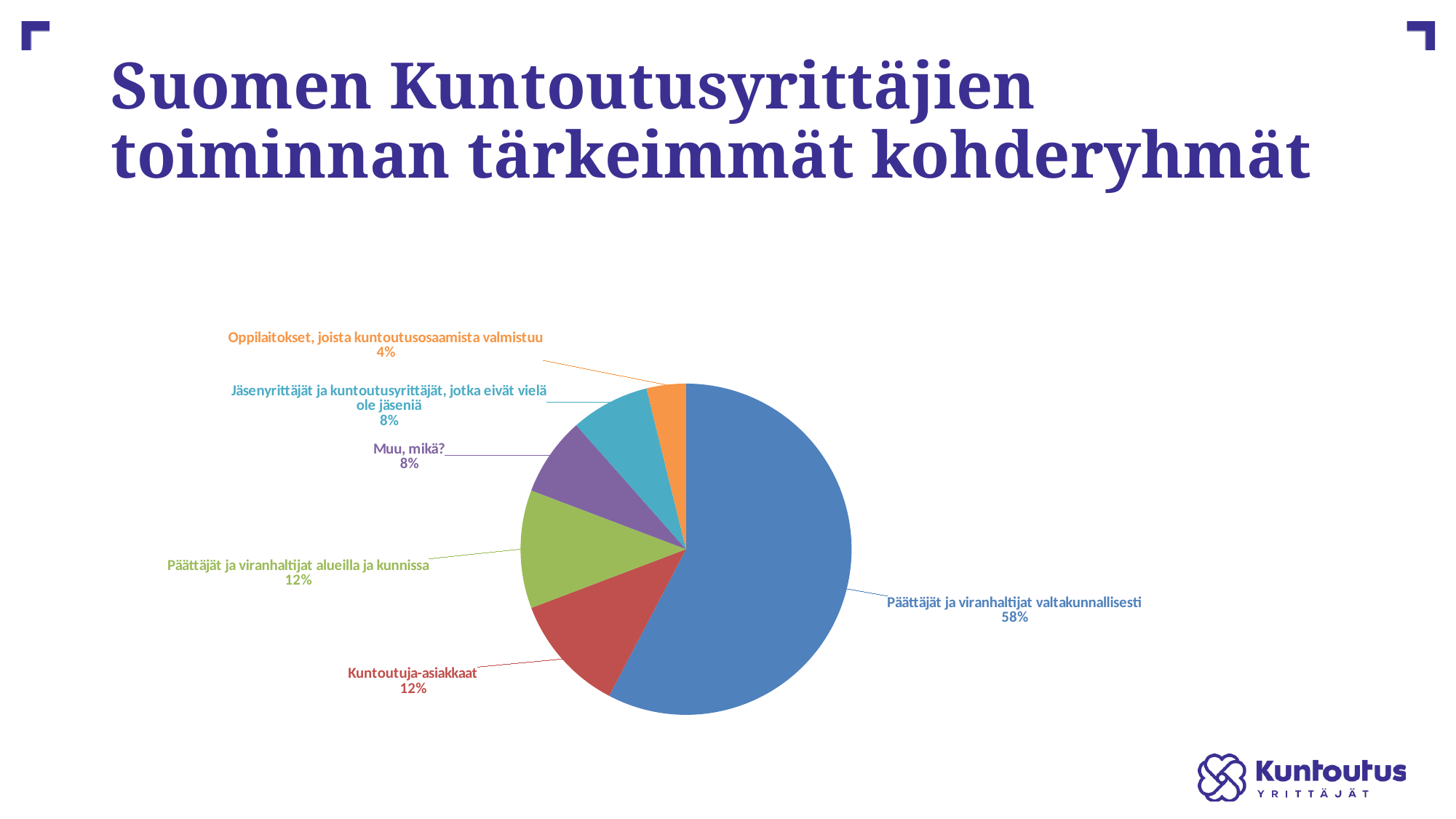
What percentage is shown for "Oppilaitokset, joista kuntoutusosaamista valmistuu"? 4% What colour is the slice for "Päättäjät ja viranhaltijat alueilla ja kunnissa"? Green What kind of chart is shown on the slide? Pie chart Which category has the smallest slice of the pie? Oppilaitokset, joista kuntoutusosaamista valmistuu What share of the pie does "Päättäjät ja viranhaltijat valtakunnallisesti" represent? 58% What is the combined share of "Muu, mikä?" and "Oppilaitokset, joista kuntoutusosaamista valmistuu"? 12% What percentage is shown for "Kuntoutuja-asiakkaat"? 12% How many slices does the pie chart have? 6 Which category has the largest slice of the pie? Päättäjät ja viranhaltijat valtakunnallisesti What percentage is shown for "Muu, mikä?"? 8% What is the difference in percentage points between "Päättäjät ja viranhaltijat valtakunnallisesti" and "Päättäjät ja viranhaltijat alueilla ja kunnissa"? 46 Which is larger: the share for "Kuntoutuja-asiakkaat" or the share for "Jäsenyrittäjät ja kuntoutusyrittäjät, jotka eivät vielä ole jäseniä"? Kuntoutuja-asiakkaat